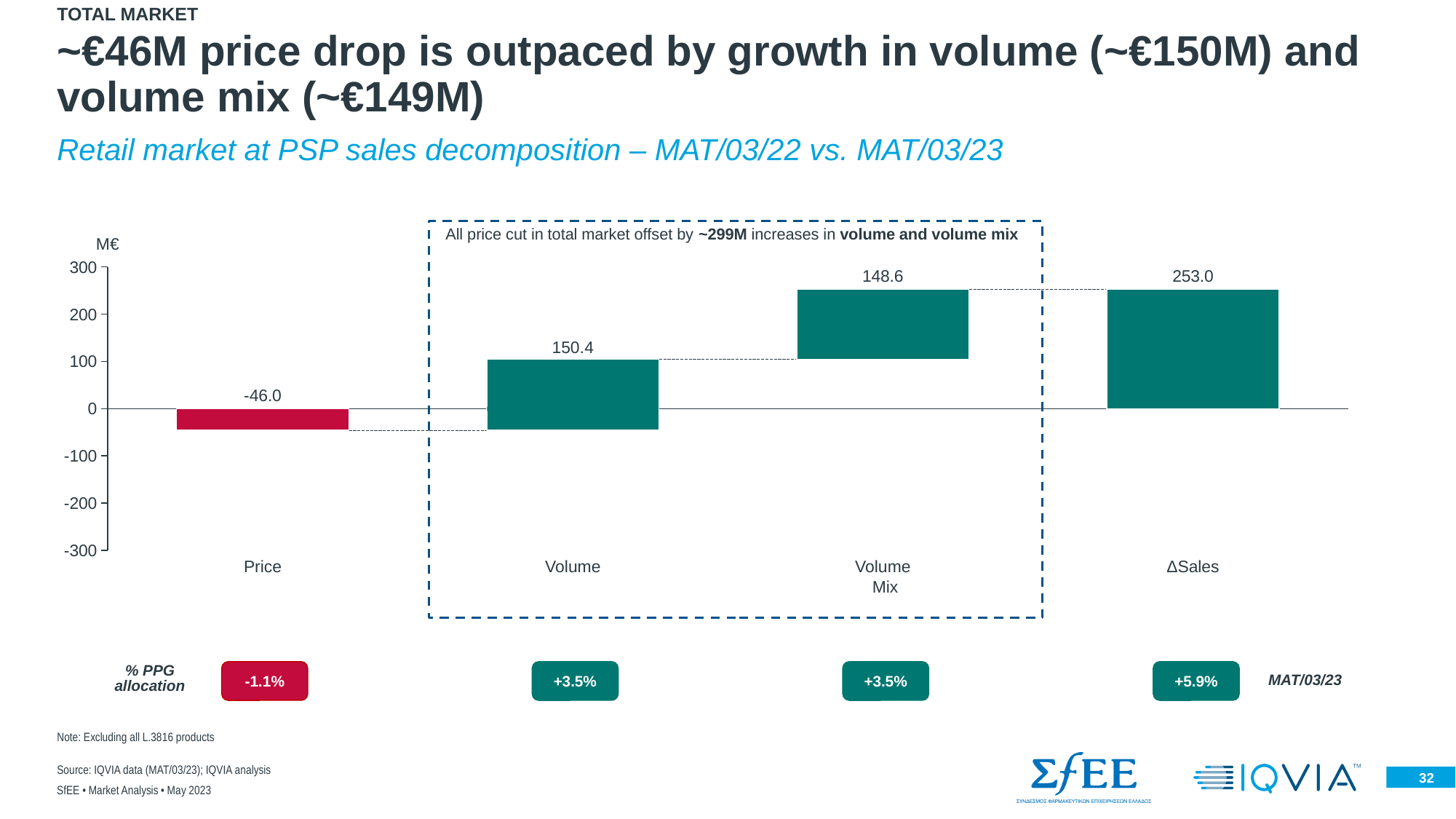
Is the value for ΔSales greater or less than 200? greater How many categories are shown on the x axis of the chart? 4 What type of chart is shown on the slide? bar chart What is the value for Volume Mix in the chart? 148.6 Which category has the highest value in the chart? ΔSales What is the value for Price in the chart? -46.0 What is the difference between the Volume value and the Volume Mix value? 1.8 What unit is shown at the top of the vertical axis of the chart? M€ Which is larger, the value for Volume or the value for Price? Volume What is the value for Volume in the chart? 150.4 What is the value for ΔSales in the chart? 253.0 Which category has the lowest value in the chart? Price